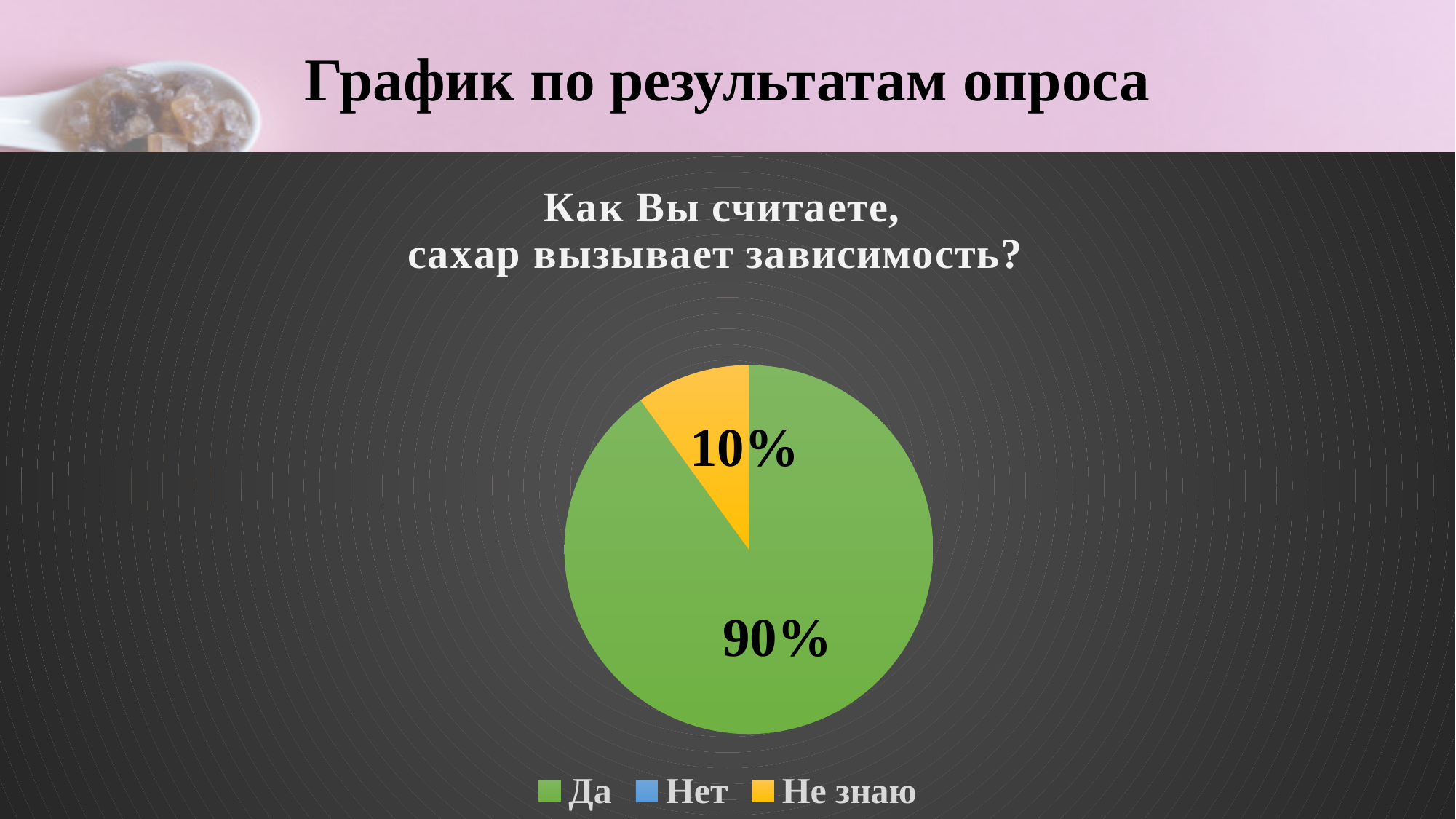
Which of the two visible slices is larger, "Да" or "Не знаю"? Да What colour represents the "Не знаю" answer? yellow What is the difference in percentage points between the "Да" and "Не знаю" slices? 80 What is the title of the chart? Как Вы считаете, сахар вызывает зависимость? How many slices are visible in the pie? 2 What kind of chart is shown on the slide? pie chart Which answer has the largest slice of the pie? Да What share of respondents answered "Не знаю"? 10% What share of respondents answered "Да"? 90% How many entries does the legend list? 3 Is the share for "Не знаю" greater or less than 50%? less